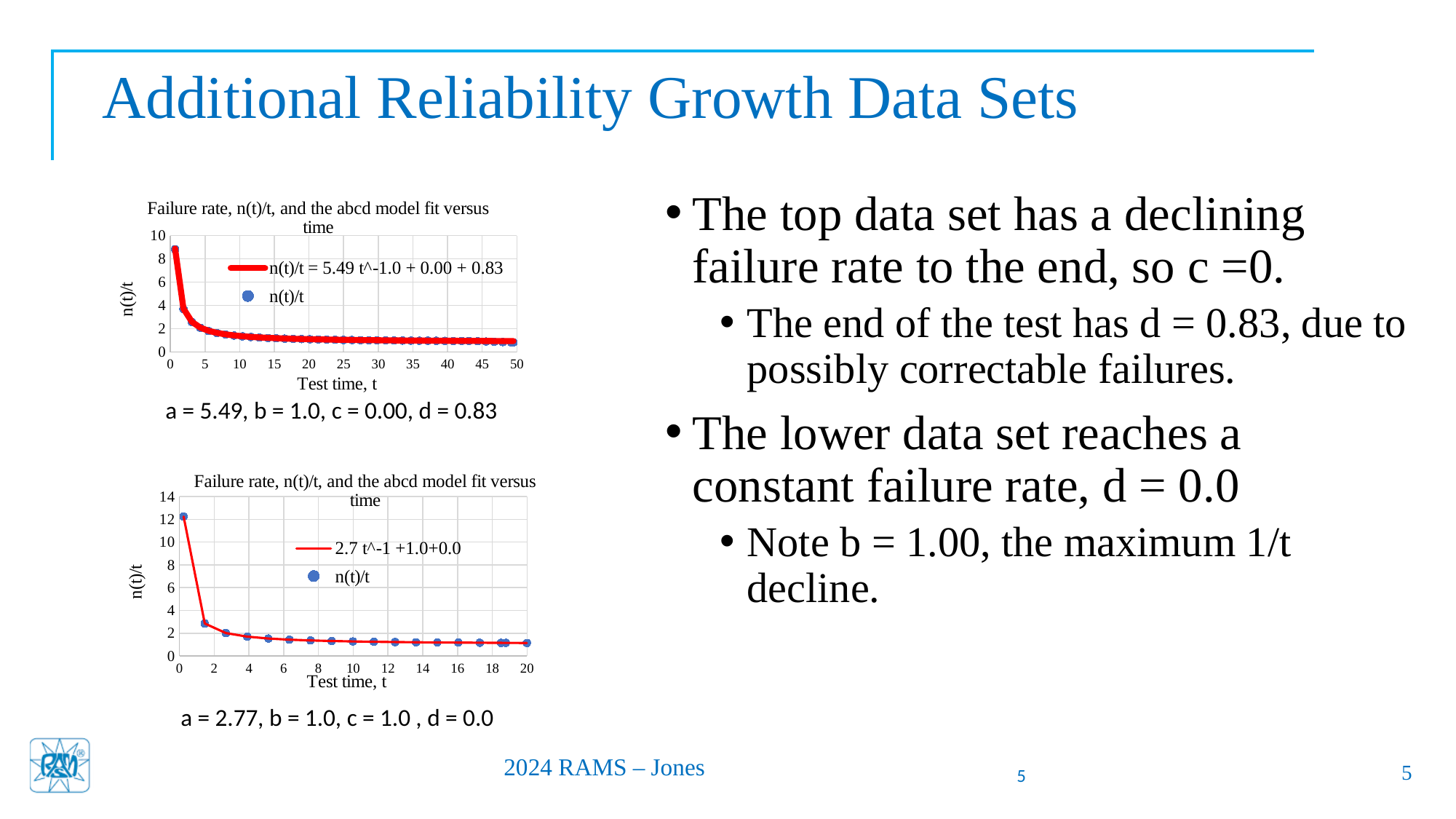
In the top chart, is the first n(t)/t value (at the smallest test time) greater or less than 8? greater In the bottom chart, is the n(t)/t value at test time 20 greater or less than 2? less What is the x-axis label of the bottom chart? Test time, t In the bottom chart, is the first n(t)/t value (at the smallest test time) greater or less than 10? greater What is the legend entry for the fitted line in the top chart? n(t)/t = 5.49 t^-1.0 + 0.00 + 0.83 How many series does the legend of the bottom chart list? 2 What kind of chart is the top chart on the slide? Scatter chart with a fitted line In the top chart, do the n(t)/t values rise or fall as test time increases? Fall How many series does the legend of the top chart list? 2 In the bottom chart, do the n(t)/t values rise or fall as test time increases? Fall